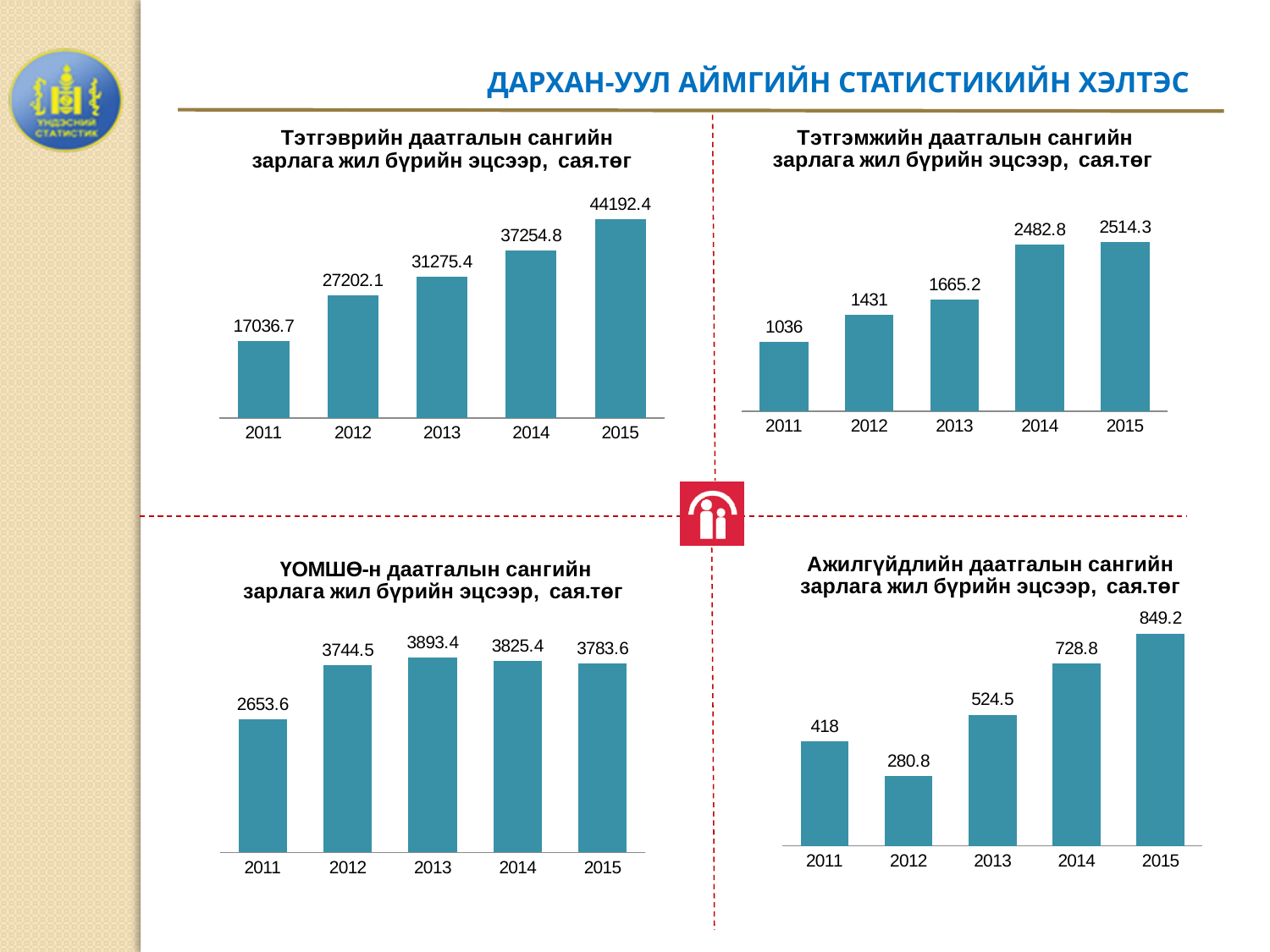
In the top-right chart (Тэтгэмжийн даатгалын сангийн зарлага), which year has the lowest value? 2011 In the top-left chart (Тэтгэврийн даатгалын сангийн зарлага), what is the value for 2015? 44192.4 In the top-right chart (Тэтгэмжийн даатгалын сангийн зарлага), what is the difference between the 2012 and 2011 values? 395 In the top-left chart (Тэтгэврийн даатгалын сангийн зарлага), do the values rise or fall from 2011 to 2015? rise In the bottom-right chart (Ажилгүйдлийн даатгалын сангийн зарлага), which year has the lowest value? 2012 How many years are shown on the x axis of the top-left chart (Тэтгэврийн даатгалын сангийн зарлага)? 5 In the top-left chart (Тэтгэврийн даатгалын сангийн зарлага), what is the value for 2011? 17036.7 In the bottom-left chart (ҮОМШӨ-н даатгалын сангийн зарлага), what is the value for 2011? 2653.6 In the top-right chart (Тэтгэмжийн даатгалын сангийн зарлага), what is the value for 2013? 1665.2 In the bottom-right chart (Ажилгүйдлийн даатгалын сангийн зарлага), what is the value for 2014? 728.8 In the bottom-left chart (ҮОМШӨ-н даатгалын сангийн зарлага), which year has the highest value? 2013 In the bottom-right chart (Ажилгүйдлийн даатгалын сангийн зарлага), which is larger, the value for 2011 or the value for 2012? 2011